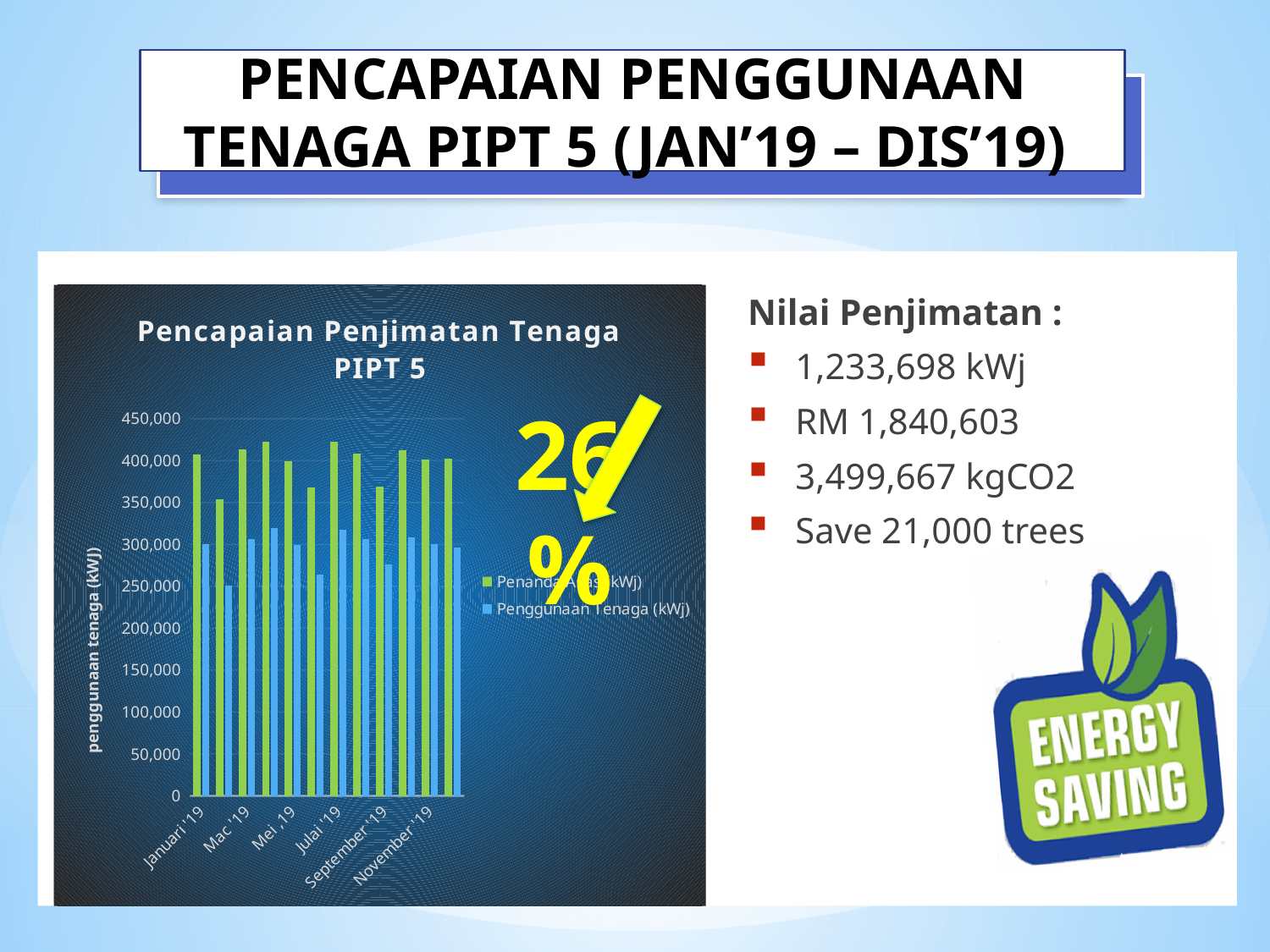
Is the Penggunaan Tenaga (kWj) value for Januari '19 greater or less than 350,000? less Is the Penggunaan Tenaga (kWj) value for Julai '19 greater or less than 350,000? less How many category labels are printed along the x axis of the chart? 6 Is the Penanda Aras (kWj) value for November '19 greater or less than 350,000? greater What kind of chart is shown on the slide? bar chart What is the label of the vertical axis of the chart? penggunaan tenaga (kWj) How many series does the chart's legend list? 2 What is the title of the chart on the slide? Pencapaian Penjimatan Tenaga PIPT 5 For Januari '19, which series has the larger value: Penanda Aras (kWj) or Penggunaan Tenaga (kWj)? Penanda Aras (kWj)